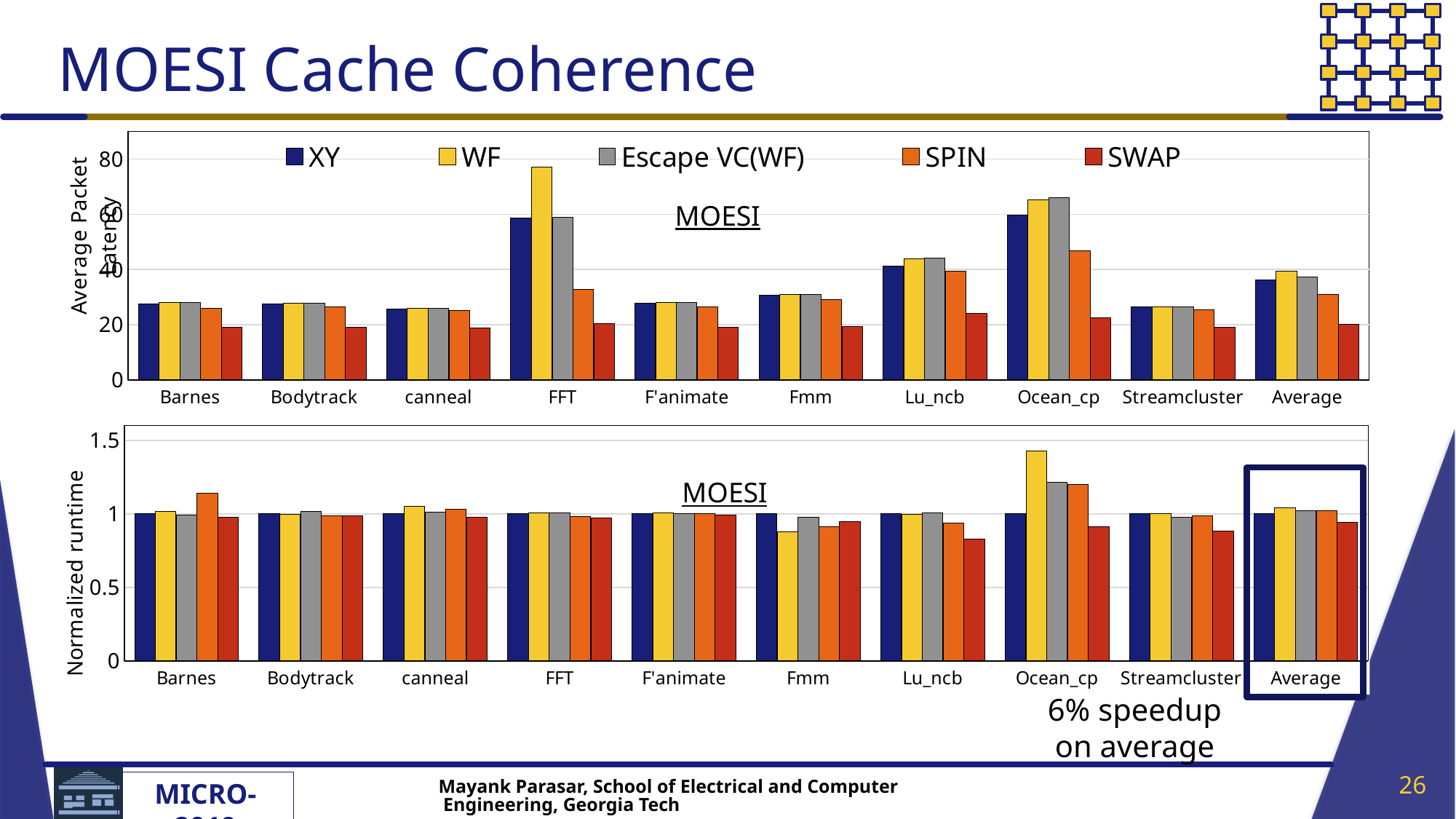
In the top chart (Average Packet Latency), which is larger: the XY value for FFT or the XY value for Barnes? FFT In the top chart (Average Packet Latency), which series has the lowest bar for the Average category? SWAP In the bottom chart (Normalized runtime), which category has the tallest WF bar? Ocean_cp In the bottom chart (Normalized runtime), which is larger for Ocean_cp: the WF bar or the SWAP bar? WF In the bottom chart (Normalized runtime), is the WF value for Fmm greater or less than 1? less In the top chart (Average Packet Latency), which category has the tallest WF bar? FFT In the top chart (Average Packet Latency), is the WF value for FFT greater or less than 60? greater In the top chart (Average Packet Latency), is the SWAP value for Ocean_cp greater or less than 40? less How many series does the legend of the top chart list? 5 How many benchmark categories are shown on the x axis of the bottom chart (Normalized runtime)? 10 What kind of chart is the top chart (Average Packet Latency)? bar chart Which category in the bottom chart (Normalized runtime) is highlighted with a box? Average